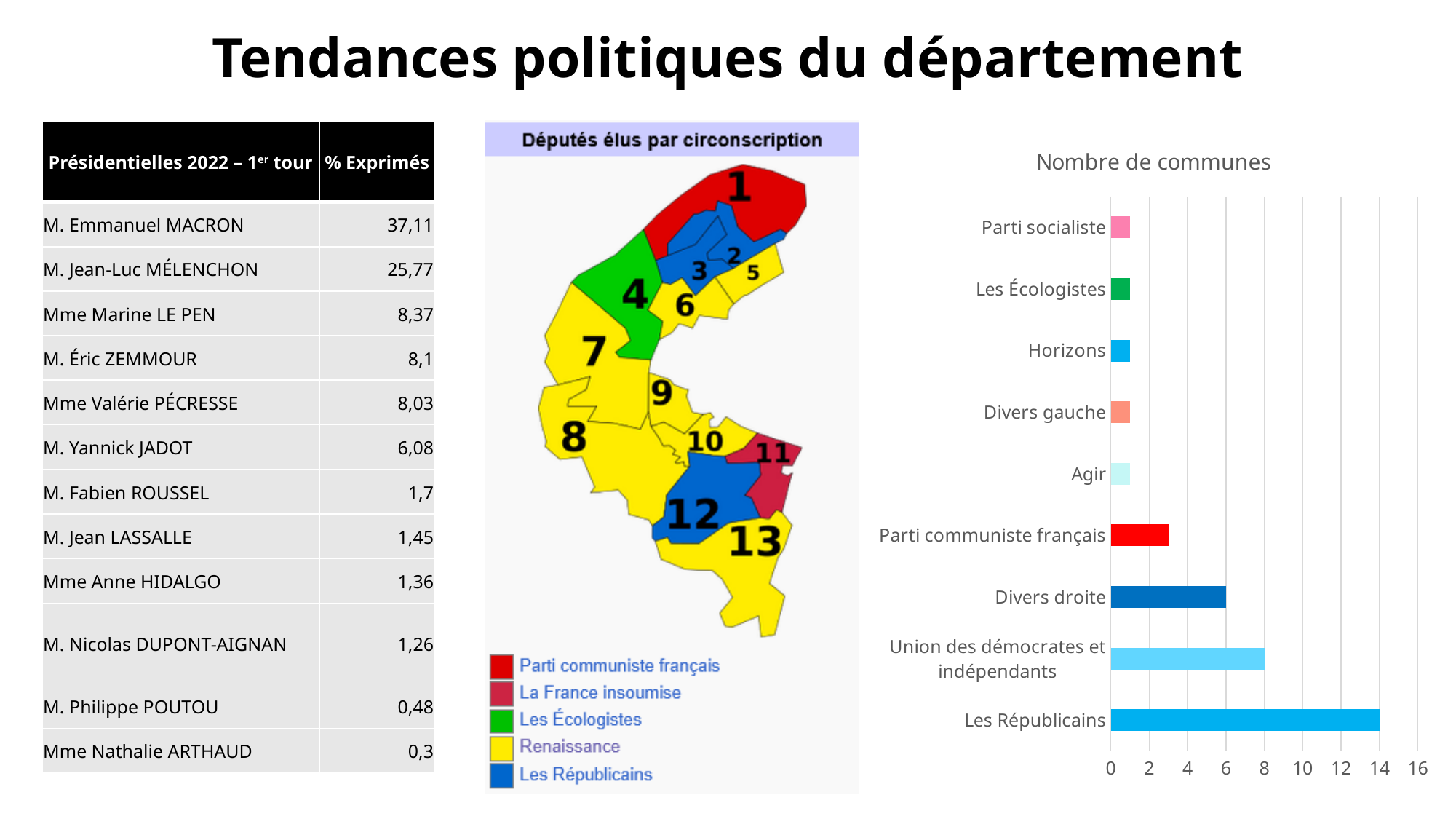
What kind of chart is the 'Nombre de communes' chart? bar chart In the 'Nombre de communes' chart, what is the value for Divers droite? 6 In the 'Nombre de communes' chart, which is larger: Divers droite or Parti communiste français? Divers droite In the 'Nombre de communes' chart, which party has the highest number of communes? Les Républicains In the 'Nombre de communes' chart, what is the value for Les Républicains? 14 In the 'Nombre de communes' chart, is the value for Parti communiste français greater or less than 4? less In the 'Nombre de communes' chart, is the value for Agir greater or less than 2? less What is the title of the bar chart on the right of the slide? Nombre de communes In the 'Nombre de communes' chart, what is the difference between Les Républicains and Union des démocrates et indépendants? 6 In the 'Nombre de communes' chart, is the value for Parti communiste français greater or less than 2? greater How many categories are shown in the 'Nombre de communes' chart? 9 In the 'Nombre de communes' chart, what is the value for Union des démocrates et indépendants? 8